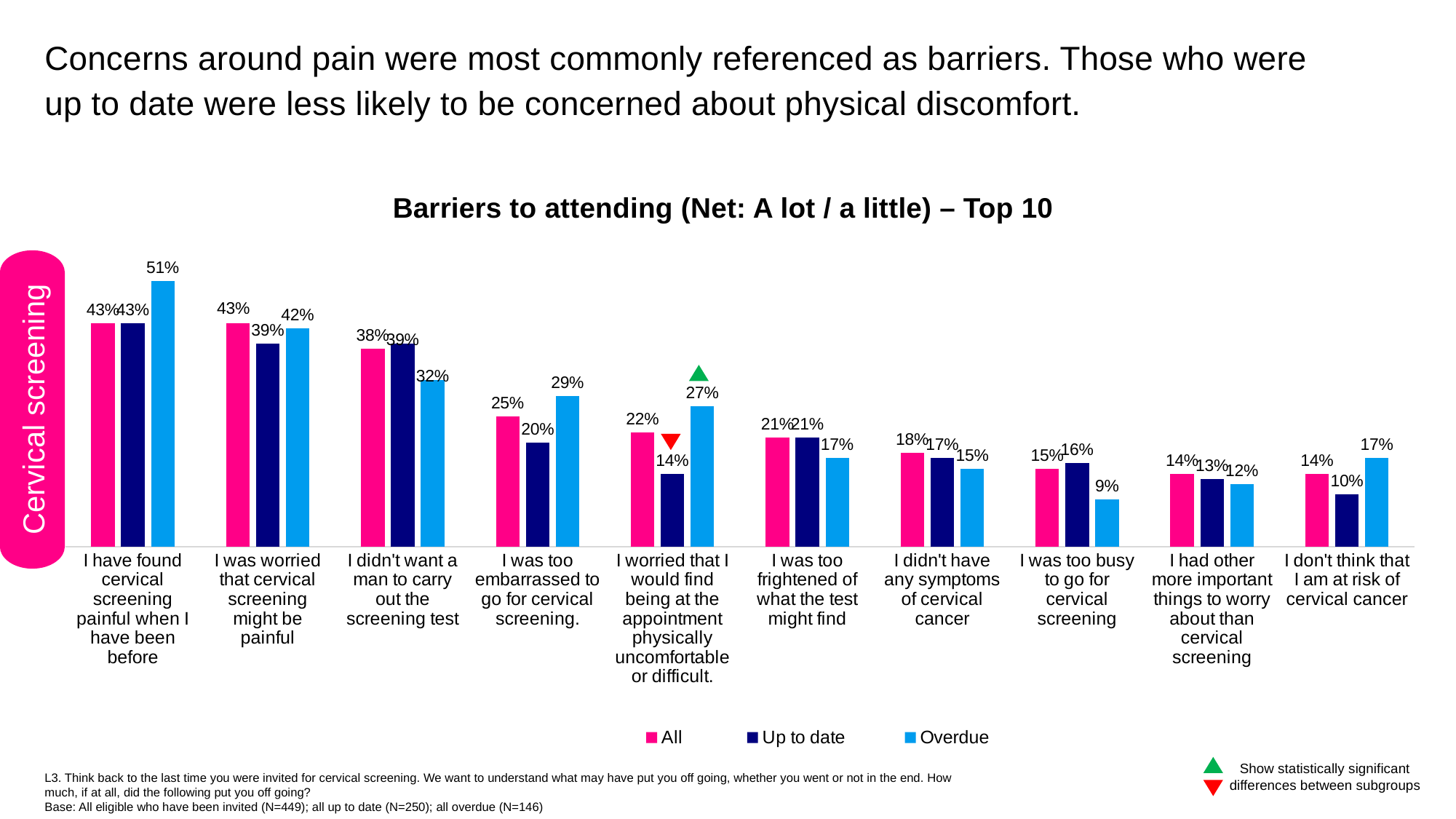
What is the All value for "I was too embarrassed to go for cervical screening."? 25% What is the Overdue value for "I was too busy to go for cervical screening"? 9% What is the Up to date value for "I worried that I would find being at the appointment physically uncomfortable or difficult."? 14% What is the Overdue value for "I have found cervical screening painful when I have been before"? 51% What kind of chart is shown on the slide? Bar chart How many series does the legend list? 3 How many categories are shown on the x axis? 10 What is the title of the chart? Barriers to attending (Net: A lot / a little) – Top 10 Which category has the lowest Up to date value? I don't think that I am at risk of cervical cancer What is the difference between the Overdue and Up to date values for "I worried that I would find being at the appointment physically uncomfortable or difficult."? 13% For "I didn't want a man to carry out the screening test", which is larger: the Up to date value or the Overdue value? Up to date Which category has the highest Overdue value? I have found cervical screening painful when I have been before